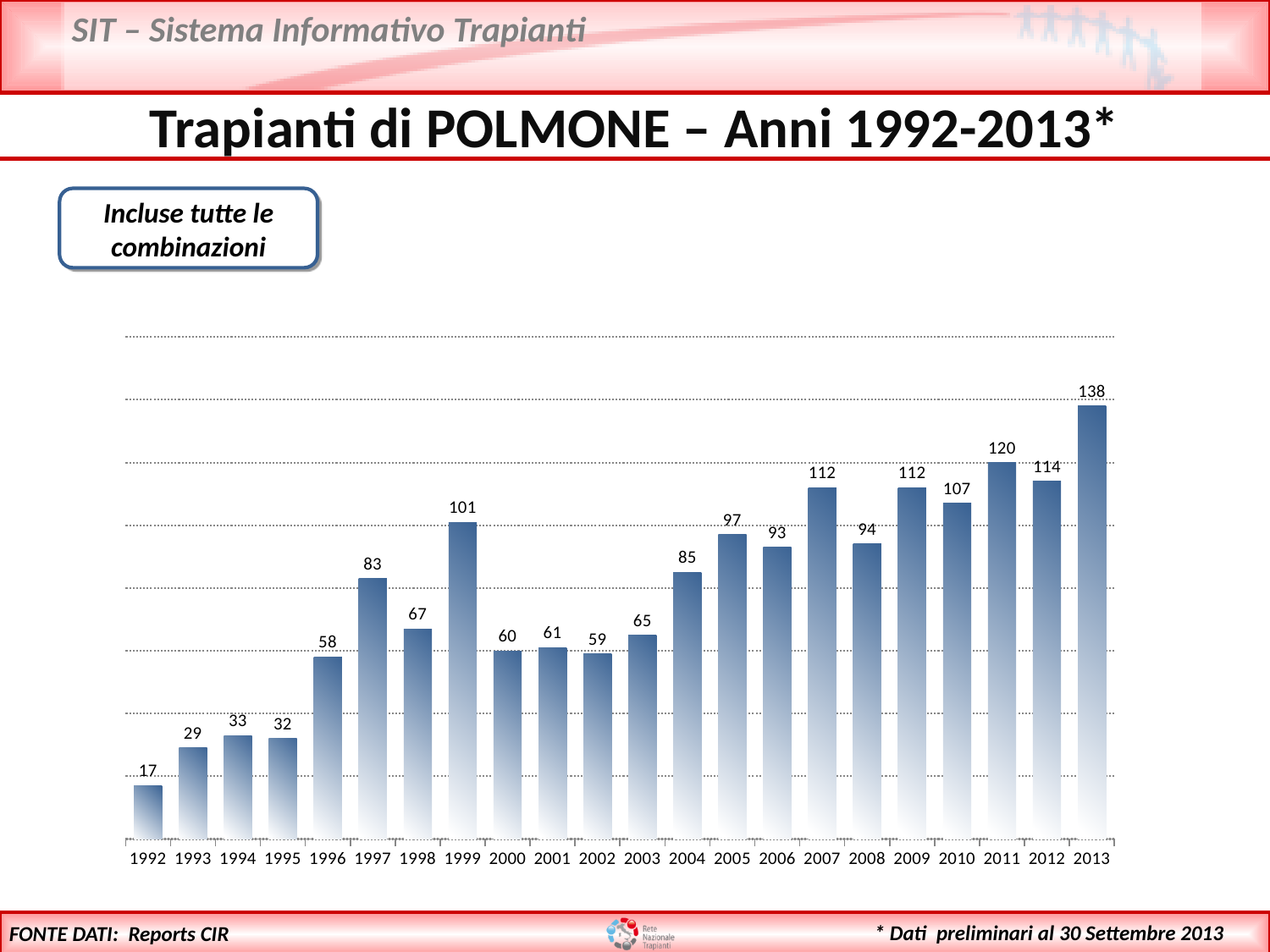
What is the title of the slide containing the chart? Trapianti di POLMONE – Anni 1992-2013* Which year has the lowest value? 1992 Which is larger, the value for 2007 or the value for 2008? 2007 What is the difference between the values for 1996 and 1995? 26 How many years are shown on the x axis? 22 What is the difference between the values for 2013 and 2012? 24 What kind of chart is shown on the slide? Bar chart What is the value for 2013? 138 What is the value for 1992? 17 Which year has the highest value? 2013 Do the values generally rise or fall from 1992 to 2013? Rise What is the value for 1999? 101